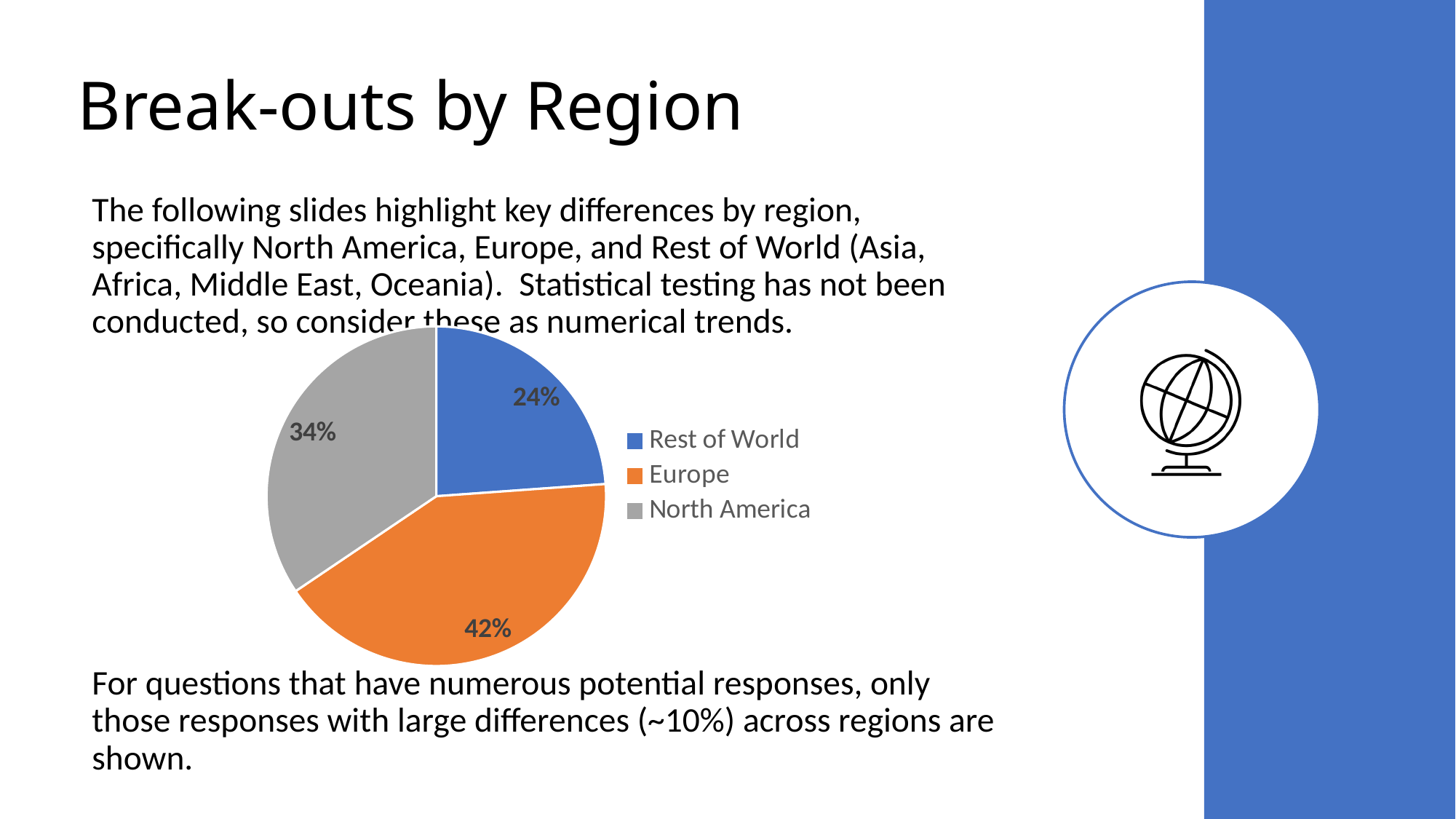
What is the difference in percentage points between Europe and Rest of World? 18 Which region has the largest slice of the pie? Europe What is the difference in percentage points between North America and Rest of World? 10 Which region has the smallest slice of the pie? Rest of World What share of the pie does Rest of World represent? 24% How many slices does the pie chart have? 3 Which colour represents Europe in the pie chart? orange Which is larger, the share for North America or the share for Rest of World? North America What share of the pie does Europe represent? 42% What share of the pie does North America represent? 34% What kind of chart is shown on the slide? pie chart How many entries does the legend list? 3